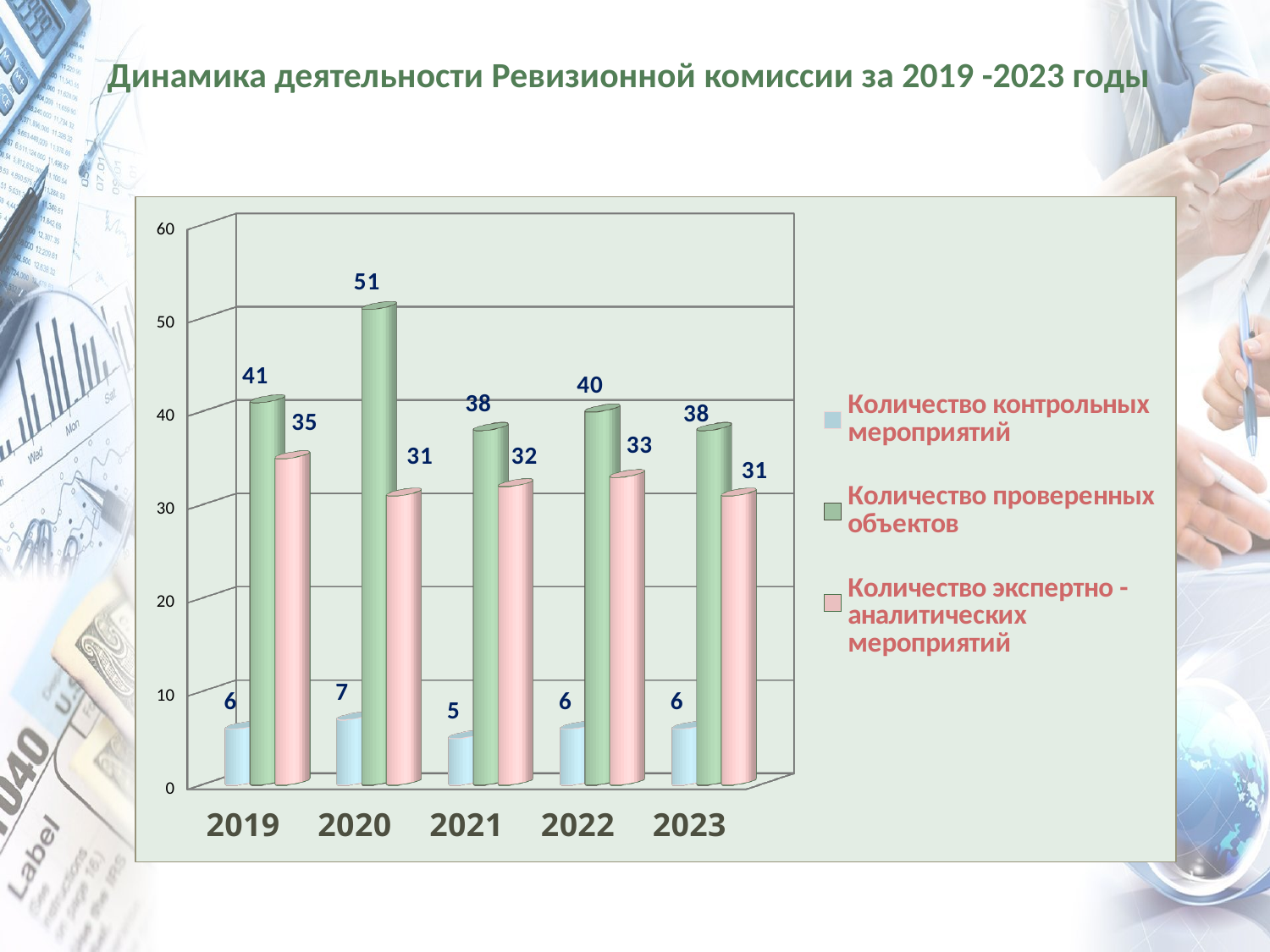
How many years are shown on the x axis? 5 Is the value of Количество проверенных объектов in 2020 greater or less than 50? greater How many series does the legend list? 3 In which year is Количество проверенных объектов highest? 2020 What kind of chart is shown on the slide? bar chart In which year is Количество контрольных мероприятий lowest? 2021 What is the value of Количество экспертно-аналитических мероприятий in 2019? 35 What is the value of Количество контрольных мероприятий in 2021? 5 Which is larger in 2022: Количество проверенных объектов or Количество экспертно-аналитических мероприятий? Количество проверенных объектов What is the title of the slide? Динамика деятельности Ревизионной комиссии за 2019 -2023 годы What is the value of Количество проверенных объектов in 2020? 51 What is the difference between Количество проверенных объектов in 2020 and in 2019? 10